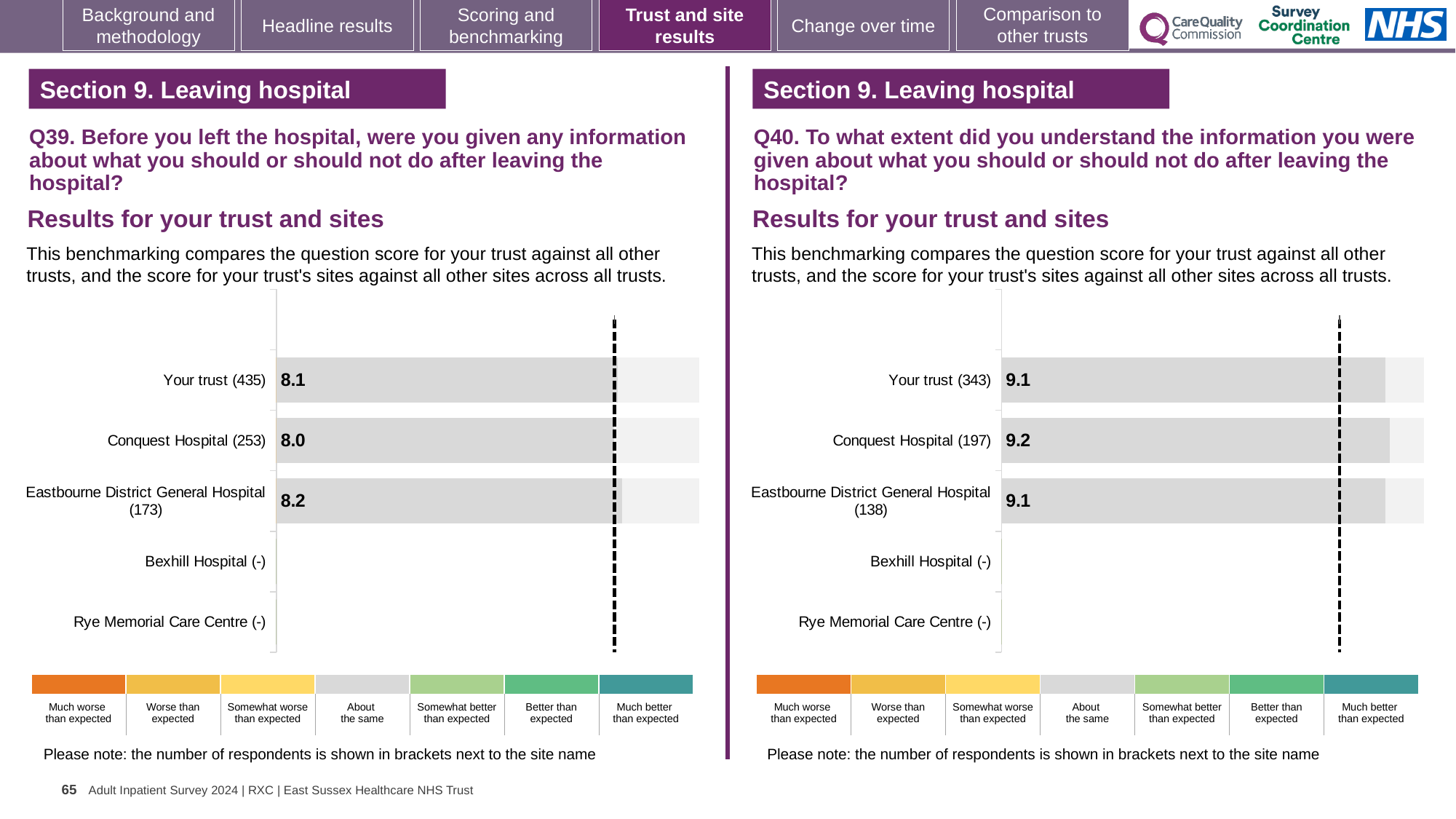
In the Q40 chart on the right, what is the score for Conquest Hospital? 9.2 In the Q40 chart on the right, what is the difference between the scores for Conquest Hospital and Your trust? 0.1 In the Q39 chart on the left, what is the score for Your trust? 8.1 What kind of chart is used on the left for Q39? Bar chart In the Q39 chart on the left, which site has the highest score? Eastbourne District General Hospital In the Q39 chart on the left, what is the difference between the scores for Eastbourne District General Hospital and Conquest Hospital? 0.2 In the Q40 chart on the right, how many respondents are shown for Eastbourne District General Hospital? 138 In the Q39 chart on the left, what is the score for Eastbourne District General Hospital? 8.2 In the Q40 chart on the right, which site has the highest score? Conquest Hospital In the Q40 chart on the right, what is the score for Eastbourne District General Hospital? 9.1 In the Q39 chart on the left, how many respondents are shown for Your trust? 435 In the Q39 chart on the left, what is the score for Conquest Hospital? 8.0